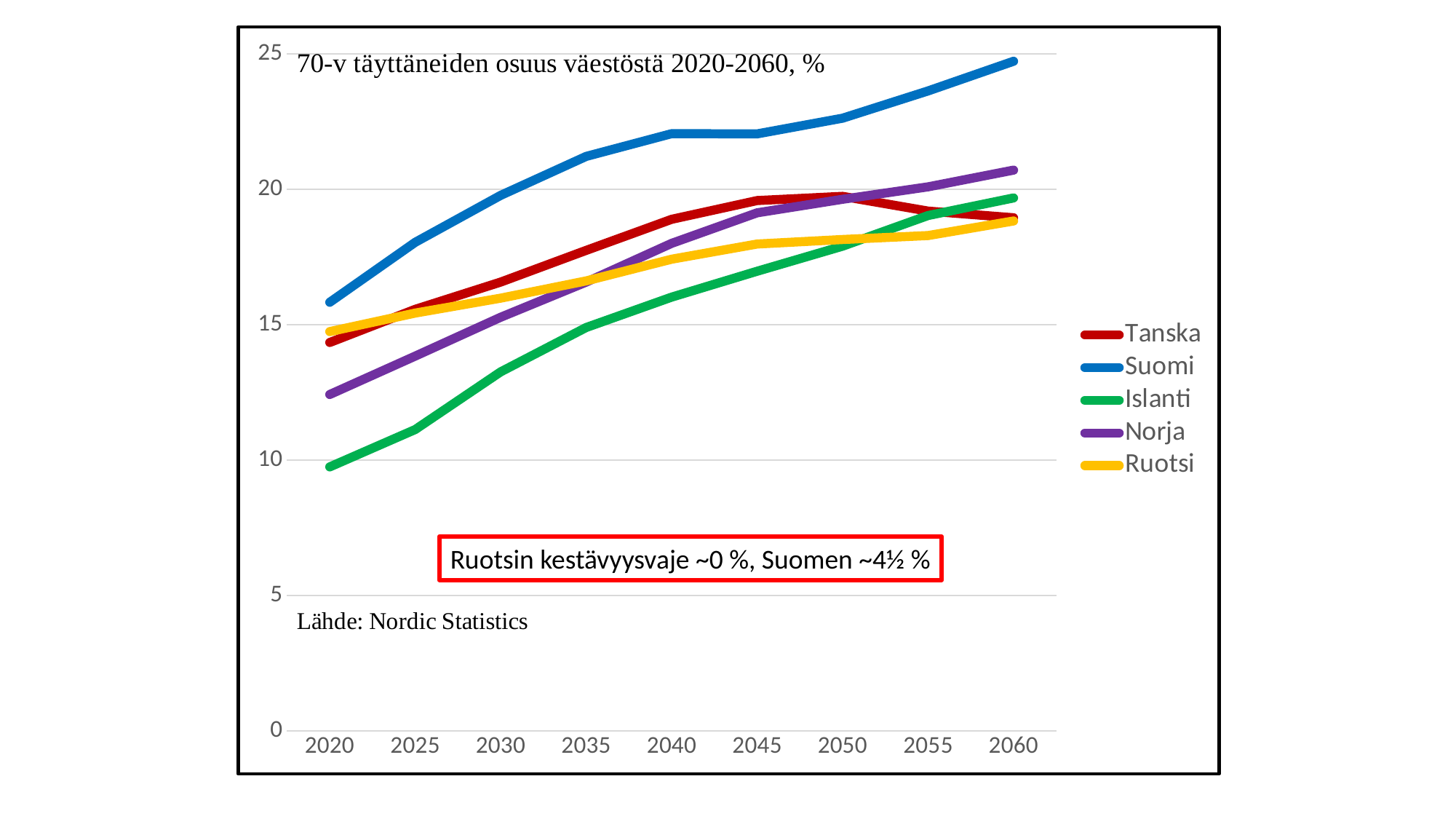
What source is cited for the chart? Nordic Statistics What kind of chart is shown on the slide? line chart How many years are marked along the x axis? 9 Which country has the highest share of people aged 70+ in 2060? Suomi Which country has the highest value in 2020? Suomi How many series does the legend list? 5 Is the value for Norja in 2020 greater or less than 15? less Is the value for Suomi in 2060 greater or less than 20? greater Is the value for Ruotsi in 2060 greater or less than 20? less Does the Suomi line rise or fall from 2020 to 2060? rise In 2060, which is larger: the value for Norja or the value for Ruotsi? Norja Which country has the lowest share of people aged 70+ in 2020? Islanti